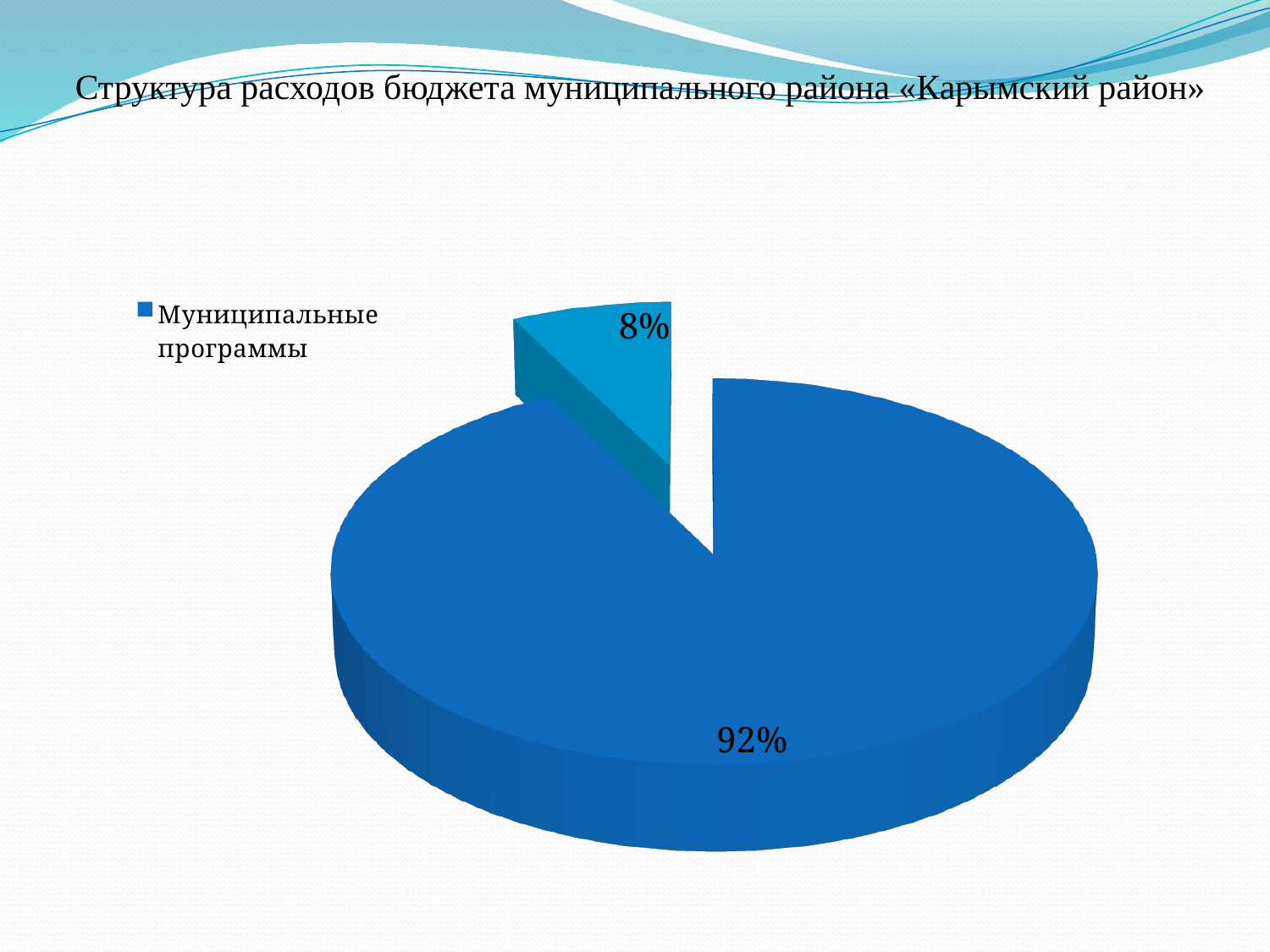
Which slice of the pie is the largest? The 92% slice (Муниципальные программы) What is the value shown on the smaller slice of the pie? 8% What is the title of the slide containing the pie chart? Структура расходов бюджета муниципального района «Карымский район» What is the only entry listed in the chart's legend? Муниципальные программы How many slices does the pie chart have? 2 How many entries does the legend list? 1 Which slice is larger: the one labelled 92% or the one labelled 8%? The one labelled 92% What kind of chart is shown on the slide? Pie chart What is the difference in percentage points between the two slices of the pie? 84 percentage points What share of the pie does the «Муниципальные программы» slice represent? 92% What is the value of the smallest slice of the pie? 8% What percentage of the pie is labelled for the slice corresponding to the legend entry «Муниципальные программы»? 92%